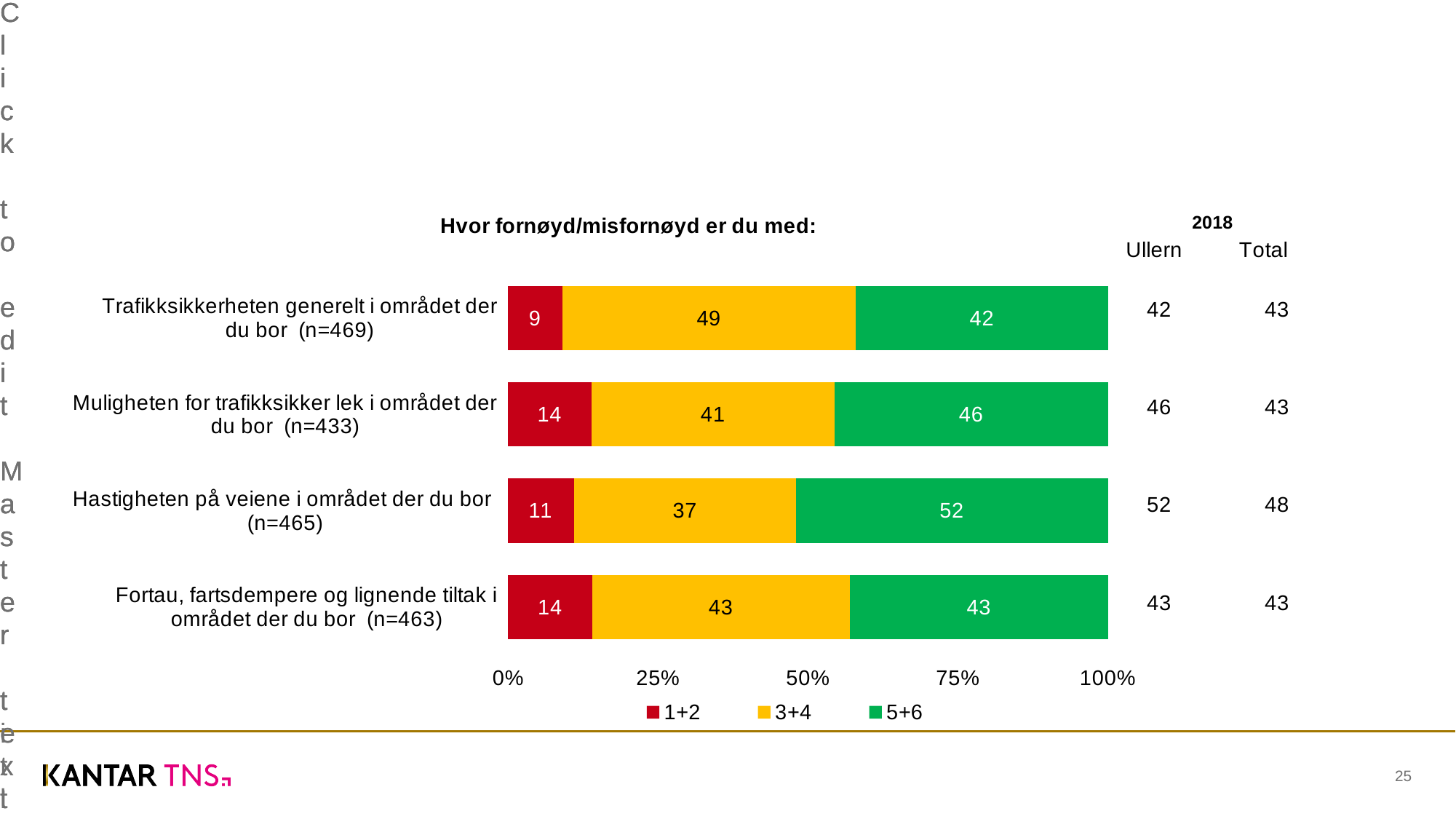
What is the title of the chart? Hvor fornøyd/misfornøyd er du med: How many series does the legend list? 3 Which is larger: the 3+4 value for "Trafikksikkerheten generelt i området der du bor (n=469)" or the 3+4 value for "Fortau, fartsdempere og lignende tiltak i området der du bor (n=463)"? Trafikksikkerheten generelt i området der du bor (n=469) What is the value of the 3+4 series for "Muligheten for trafikksikker lek i området der du bor (n=433)"? 41 What is the difference between the 5+6 values for "Hastigheten på veiene i området der du bor (n=465)" and "Trafikksikkerheten generelt i området der du bor (n=469)"? 10 What is the value of the 5+6 series for "Hastigheten på veiene i området der du bor (n=465)"? 52 What kind of chart is shown on the slide? Stacked bar chart Which category has the lowest value for the 1+2 series? Trafikksikkerheten generelt i området der du bor (n=469) Which category has the highest value for the 5+6 series? Hastigheten på veiene i området der du bor (n=465) How many categories are shown in the chart? 4 What is the value of the 1+2 series for "Trafikksikkerheten generelt i området der du bor (n=469)"? 9 What is the total of the stacked bar for "Muligheten for trafikksikker lek i området der du bor (n=433)"? 101